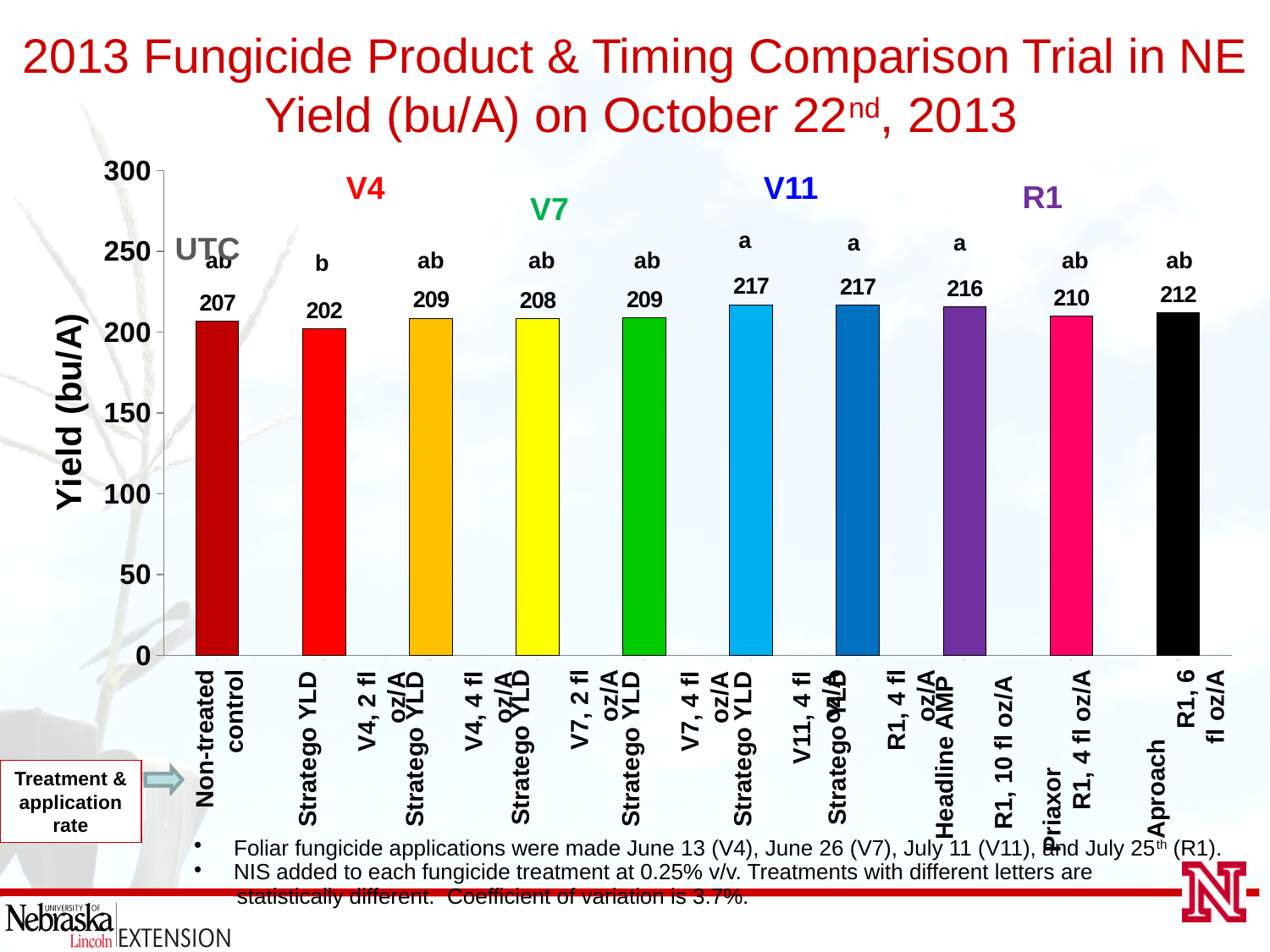
What is the difference in yield between Aproach R1, 6 fl oz/A and Priaxor R1, 4 fl oz/A? 2 What is the yield value shown for the Non-treated control bar? 207 What is the title of the vertical axis? Yield (bu/A) What is the difference in yield between Stratego YLD at V11, 4 fl oz/A and the Non-treated control? 10 What is the yield value shown for Headline AMP at R1, 10 fl oz/A? 216 Which treatment has the lowest yield in the chart? Stratego YLD V4, 2 fl oz/A What statistical letter is printed above the Stratego YLD V4, 2 fl oz/A bar? b Is the yield for the Non-treated control greater or less than 250? less Which has the higher yield: Priaxor R1, 4 fl oz/A or Stratego YLD V4, 4 fl oz/A? Priaxor R1, 4 fl oz/A How many treatment bars are plotted in the chart? 10 What is the yield value shown for Aproach at R1, 6 fl oz/A? 212 What type of chart is shown on the slide? bar chart